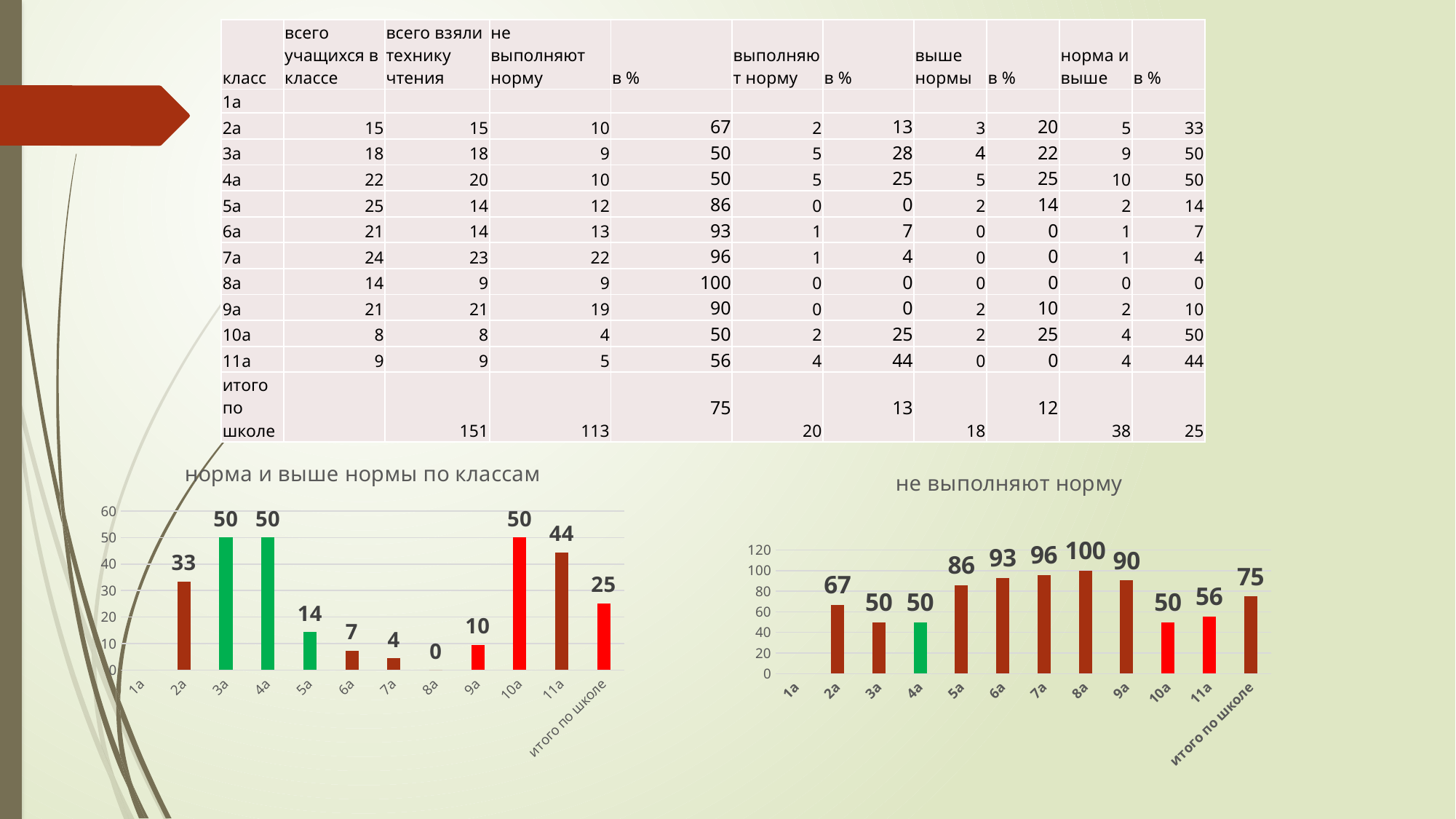
In the chart 'норма и выше нормы по классам', what is the difference between the values for 2а and 5а? 19 In the chart 'норма и выше нормы по классам', what is the value for итого по школе? 25 In the chart 'норма и выше нормы по классам', which class has the lowest value among the labelled bars? 8а What is the title of the chart on the right side of the slide? не выполняют норму What type of chart is 'норма и выше нормы по классам'? bar chart In the chart 'не выполняют норму', which class has the highest value? 8а In the chart 'норма и выше нормы по классам', what is the value for 11а? 44 In the chart 'не выполняют норму', what is the value for 6а? 93 In the chart 'не выполняют норму', what is the difference between the values for 7а and 2а? 29 In the chart 'не выполняют норму', which is larger, the value for 9а or the value for 11а? 9а In the chart 'норма и выше нормы по классам', which is larger, the value for 6а or the value for 9а? 9а How many categories are shown on the x axis of the chart 'не выполняют норму'? 12